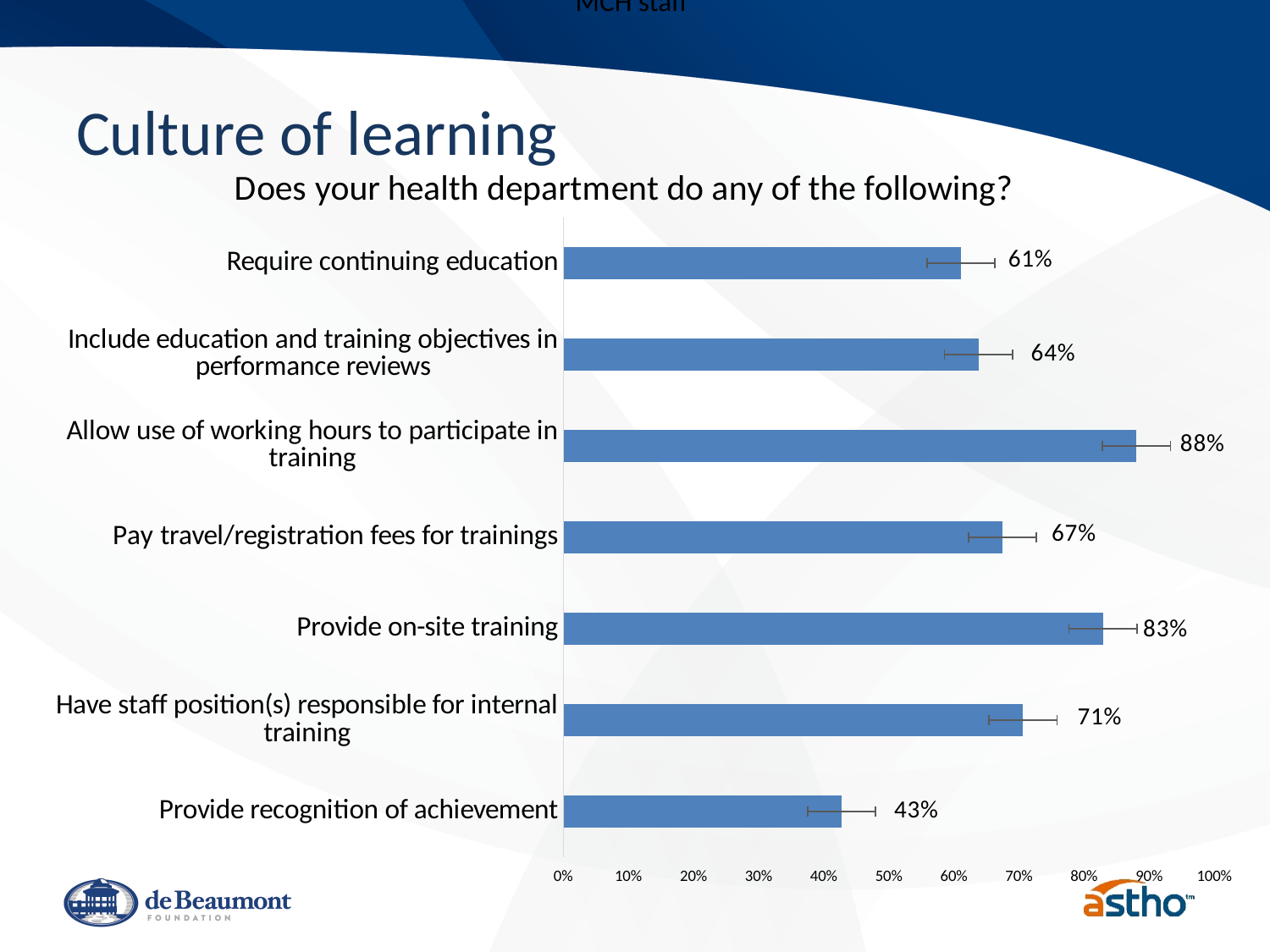
What question is posed above the chart? Does your health department do any of the following? What kind of chart is shown on the slide? Bar chart What is the value for 'Provide recognition of achievement'? 43% Is the value for 'Provide on-site training' greater or less than 80%? greater What percentage of health departments allow use of working hours to participate in training? 88% Which category has the lowest value? Provide recognition of achievement What is the value for 'Have staff position(s) responsible for internal training'? 71% Which category has the highest value? Allow use of working hours to participate in training What is the difference between 'Provide on-site training' and 'Pay travel/registration fees for trainings'? 16% Which is larger: 'Include education and training objectives in performance reviews' or 'Require continuing education'? Include education and training objectives in performance reviews How many categories are shown in the chart? 7 What percentage of health departments require continuing education? 61%